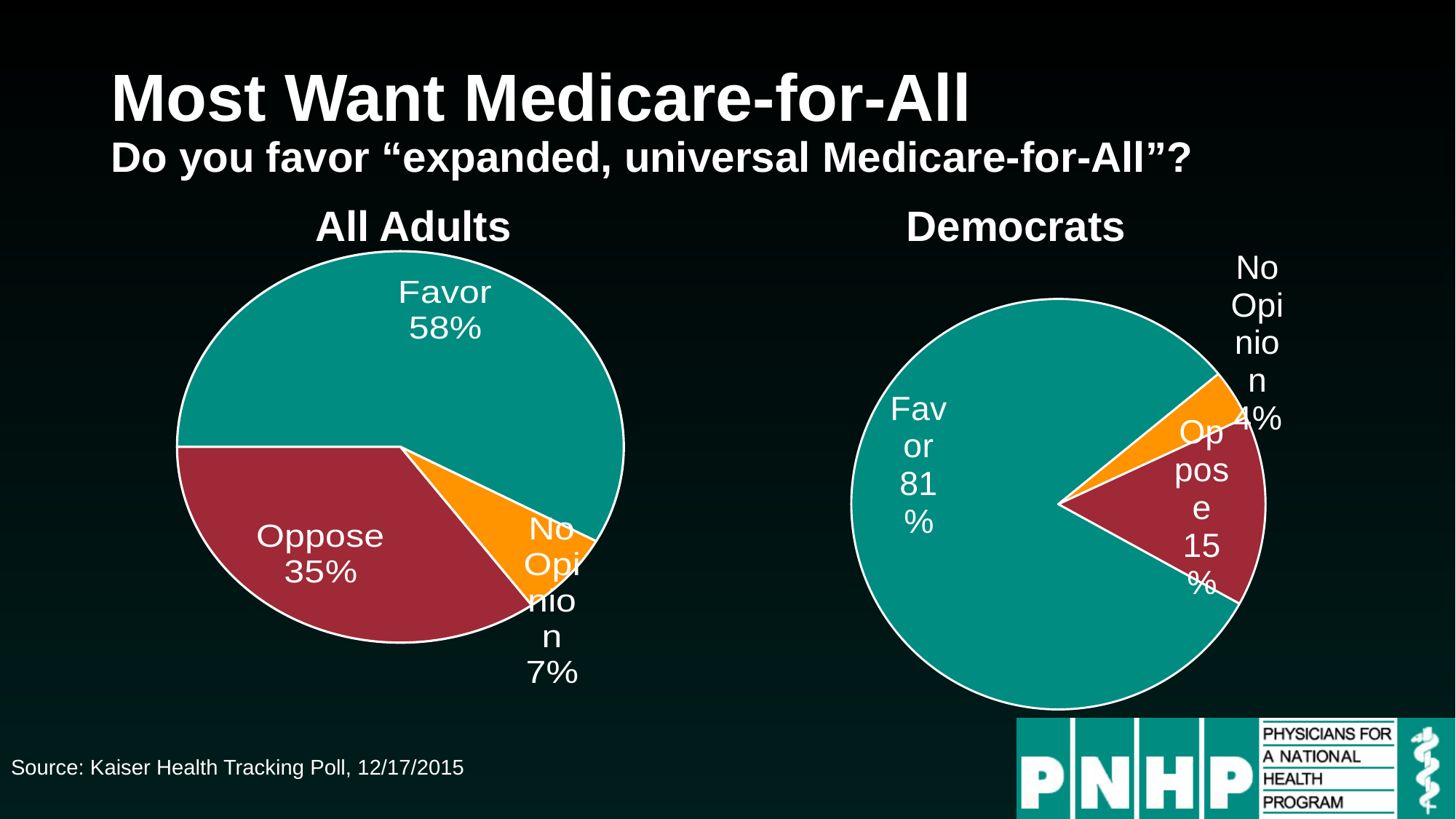
In the Democrats chart, which response has the smallest share? No Opinion In the Democrats chart, what percentage of respondents oppose Medicare-for-All? 15% How many slices does the Democrats pie chart have? 3 In the Democrats chart, what percentage of respondents favor Medicare-for-All? 81% In the All Adults chart, what percentage of respondents favor Medicare-for-All? 58% What type of chart is used for the All Adults data? Pie chart In the All Adults chart, which response has the largest share? Favor In the All Adults chart, what percentage of respondents oppose Medicare-for-All? 35% In the All Adults chart, what percentage of respondents have no opinion? 7% In the All Adults chart, what is the difference in percentage points between Favor and Oppose? 23 Which is larger: the Favor share among Democrats or the Favor share among All Adults? Democrats In the Democrats chart, what percentage of respondents have no opinion? 4%